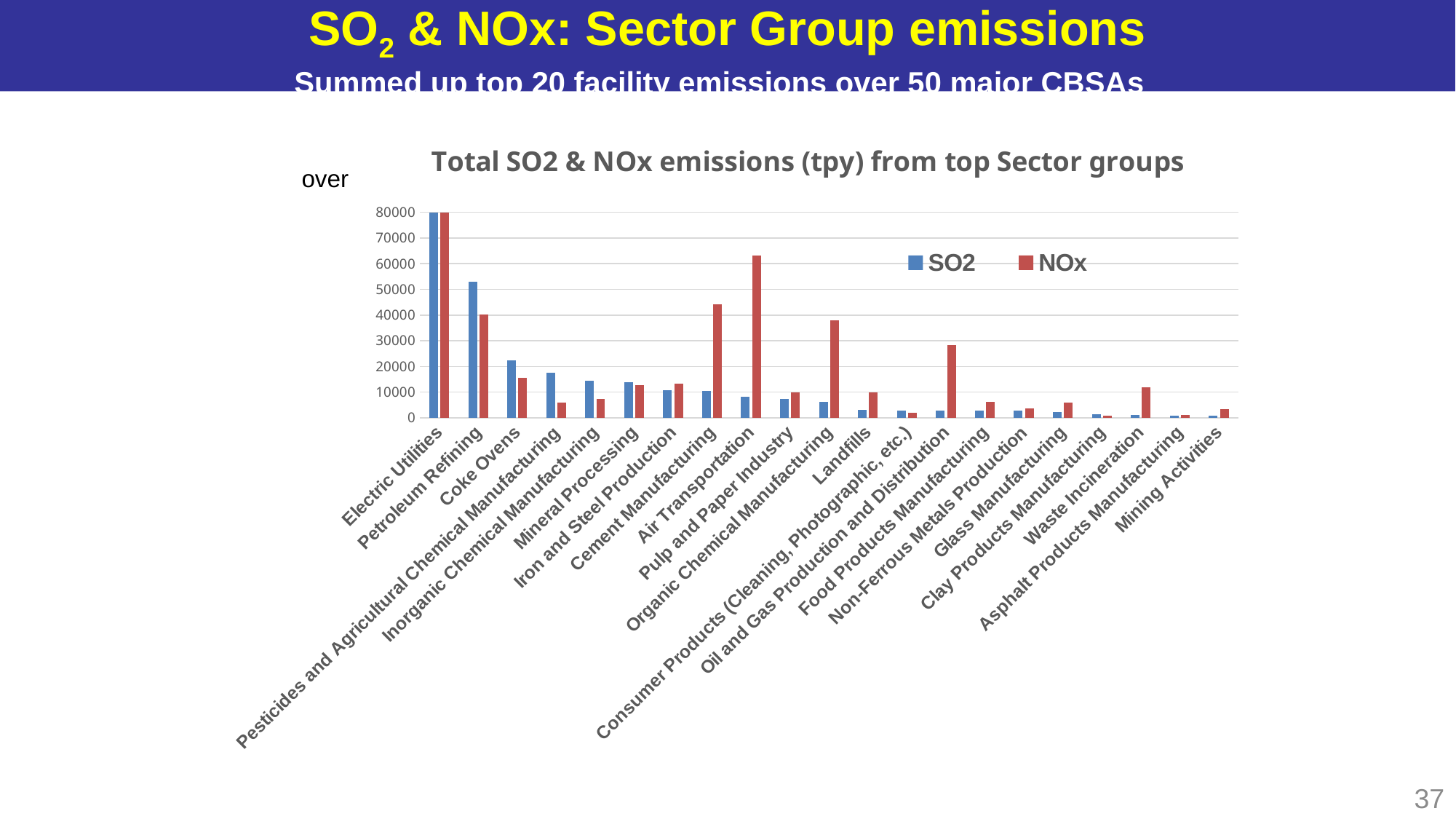
Is the NOx value for Air Transportation greater or less than 60000? greater How many sector groups are shown along the x axis? 21 Which is larger for Organic Chemical Manufacturing, SO2 or NOx? NOx Is the NOx value for Cement Manufacturing greater or less than 40000? greater Which sector group has the highest SO2 emissions? Electric Utilities Which is larger for Coke Ovens, SO2 or NOx? SO2 Do the SO2 values generally rise or fall moving from left to right along the x axis? fall Which sector group has the highest NOx emissions? Electric Utilities How many series does the legend list? 2 What kind of chart is shown on the slide? bar chart Is the SO2 value for Petroleum Refining greater or less than 50000? greater What colour represents the NOx series? red